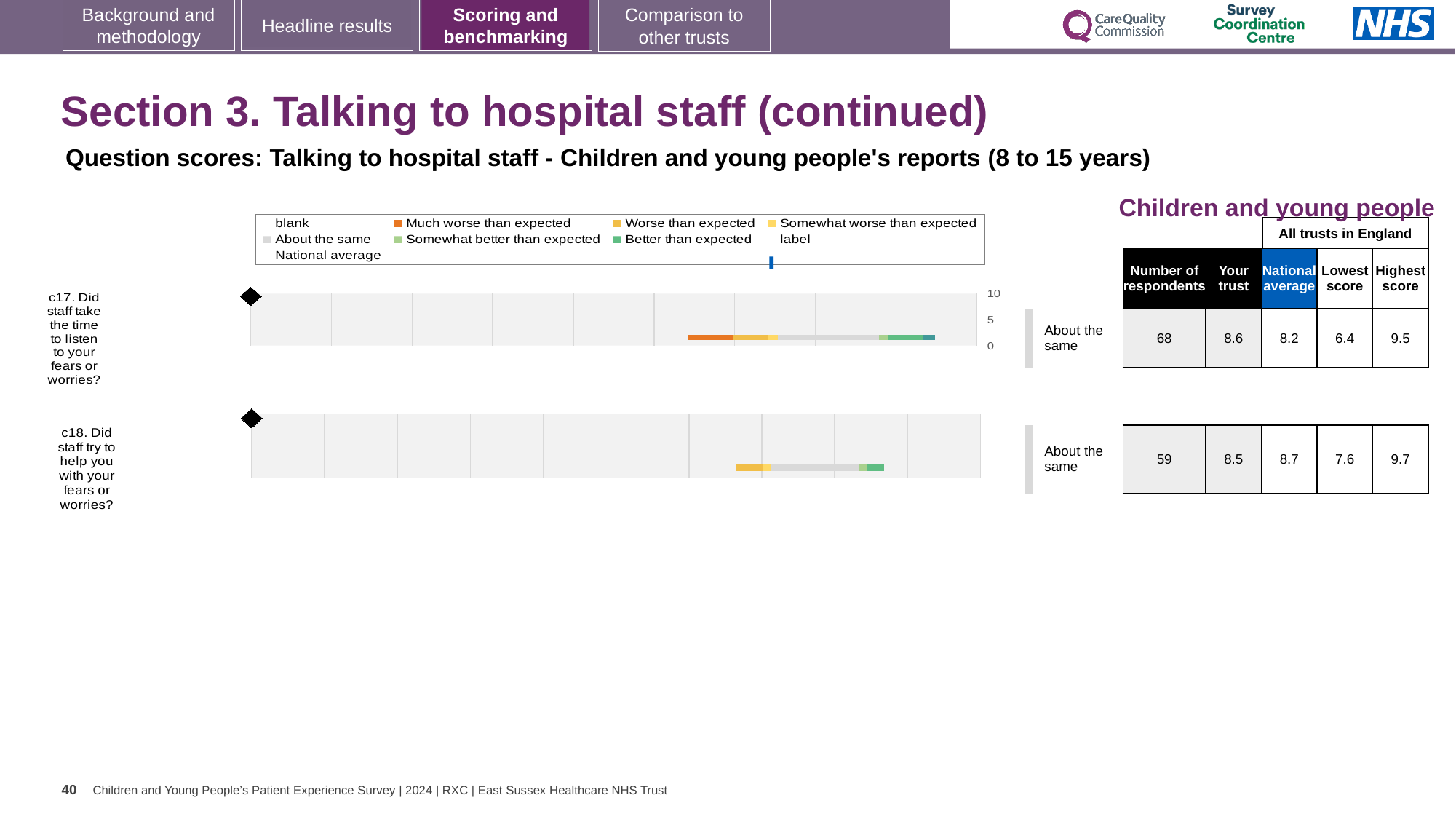
For question c18, is the 'Your trust' score or the national average score higher? National average For question c17, is the 'Your trust' score or the national average score higher? Your trust How many respondents answered question c17? 68 For question c18 (Did staff try to help you with your fears or worries?), what is the 'Your trust' score? 8.5 Which legend entry is shown in orange? Much worse than expected For question c17 (Did staff take the time to listen to your fears or worries?), what is the 'Your trust' score? 8.6 What benchmark category is shown for question c18? About the same How many questions (rows) are plotted in the chart on this slide? 2 For question c18, what is the highest score among all trusts in England? 9.7 For question c17, what is the difference between the highest score and the lowest score across all trusts in England? 3.1 What kind of chart is used to show the question scores on this slide? bar chart For question c17, what is the national average score? 8.2